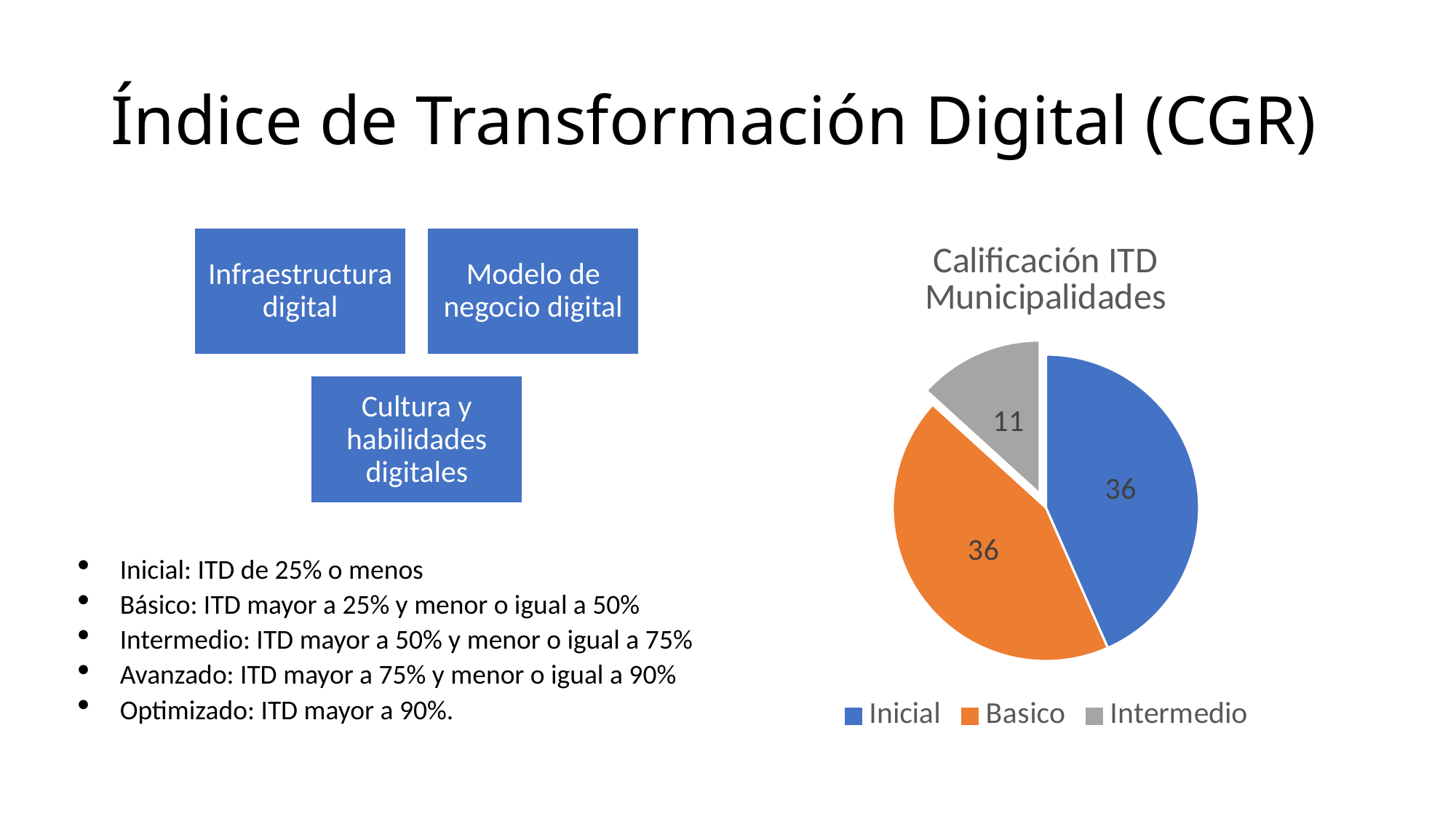
What is the title of the chart? Calificación ITD Municipalidades What is the value for Inicial in the pie chart? 36 What is the value for Basico in the pie chart? 36 Which is larger, the value for Basico or the value for Intermedio? Basico What is the difference between the values for Inicial and Intermedio? 25 What is the total of all the slices in the pie chart? 83 How many slices does the pie chart have? 3 What is the value for Intermedio in the pie chart? 11 What colour is the Basico slice in the pie chart? orange Which category has the smallest slice in the pie chart? Intermedio How many entries does the legend list? 3 What type of chart is shown on the slide? pie chart